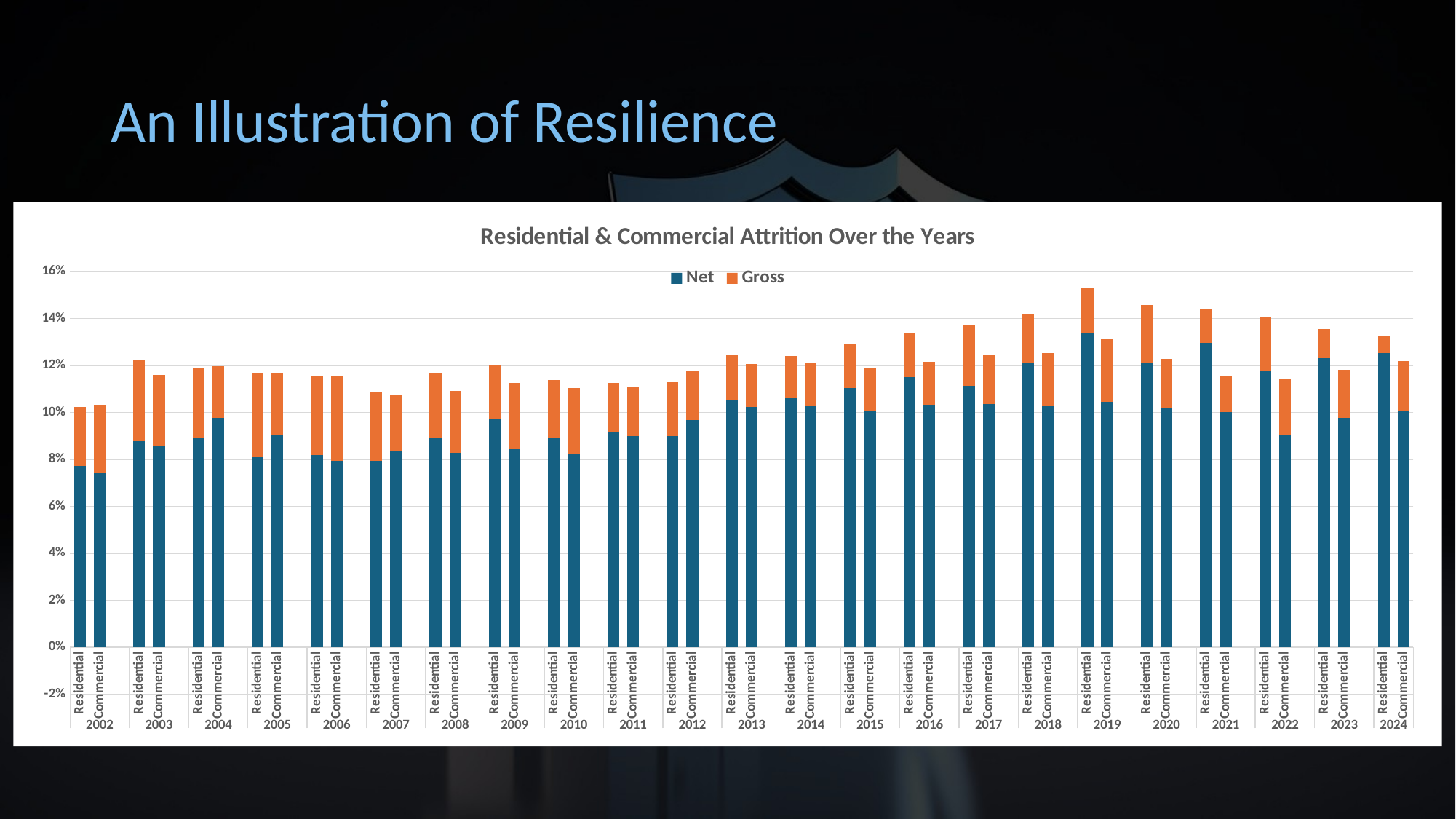
Is the total for Residential in 2002 greater or less than 12%? less How many years are shown along the x axis of the chart? 23 What kind of chart is shown on the slide? Stacked bar chart Between 2002 and 2019, do the Residential total bars generally rise or fall? Rise In 2021, which has the larger total bar, Residential or Commercial? Residential Which bar reaches the highest total in the chart? Residential 2019 Is the Net value for Residential in 2019 greater or less than 12%? greater Which colour represents the Gross series in the chart? Orange What is the title of the chart? Residential & Commercial Attrition Over the Years Is the Net value for Commercial in 2002 greater or less than 8%? less How many series does the legend list? 2